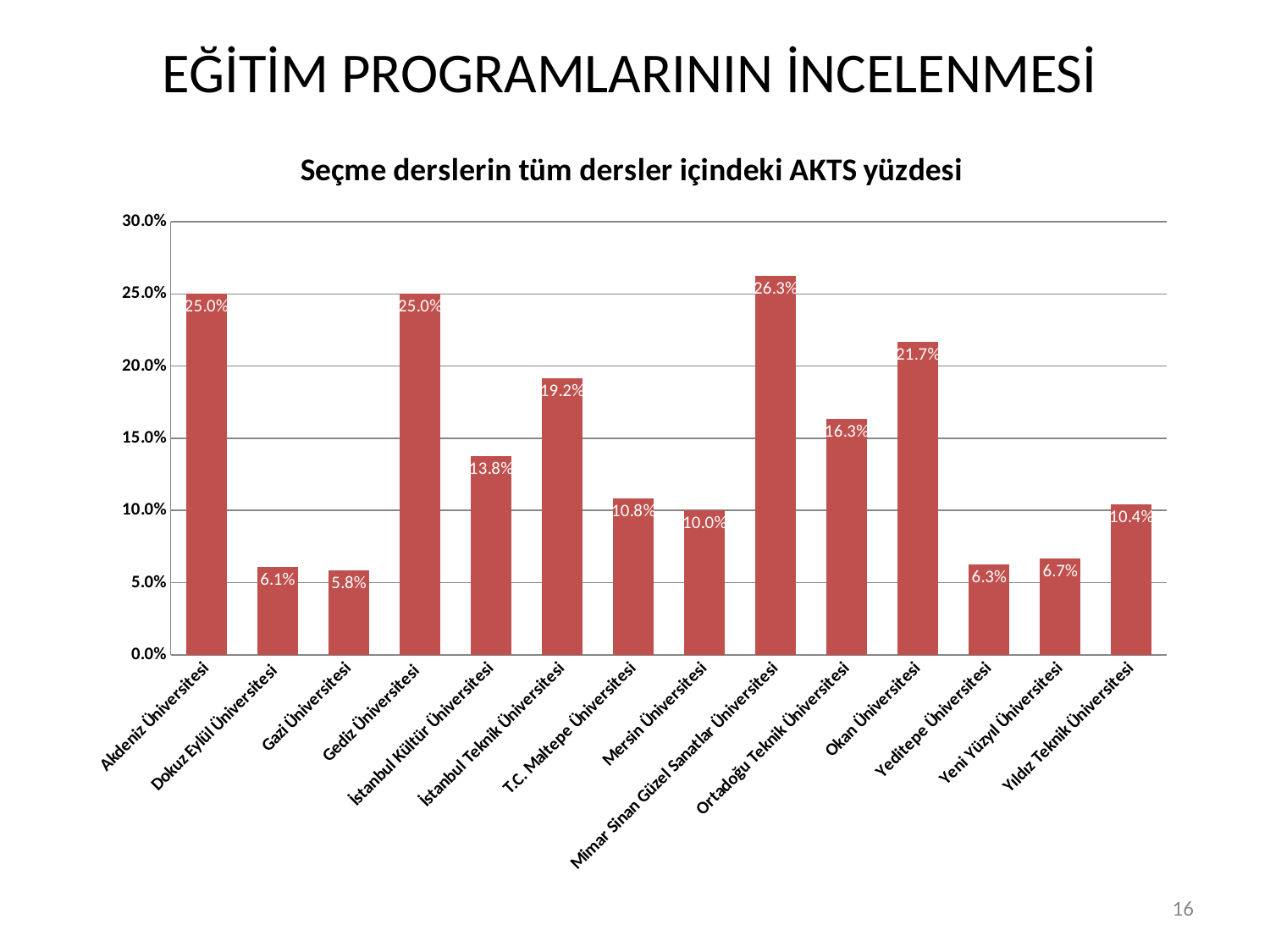
How many universities are shown on the chart? 14 Is the value for Okan Üniversitesi greater or less than 20.0%? greater What is the title of the chart? Seçme derslerin tüm dersler içindeki AKTS yüzdesi What is the value for İstanbul Teknik Üniversitesi? 19.2% Which is larger, the value for T.C. Maltepe Üniversitesi or Yıldız Teknik Üniversitesi? T.C. Maltepe Üniversitesi What is the value for Yeni Yüzyıl Üniversitesi? 6.7% Which university has the lowest value? Gazi Üniversitesi What is the difference between the values for Mimar Sinan Güzel Sanatlar Üniversitesi and Gazi Üniversitesi? 20.5% What kind of chart is shown on the slide? bar chart Which university has the highest value? Mimar Sinan Güzel Sanatlar Üniversitesi What is the value for Okan Üniversitesi? 21.7% What is the difference between the values for Ortadoğu Teknik Üniversitesi and İstanbul Kültür Üniversitesi? 2.5%